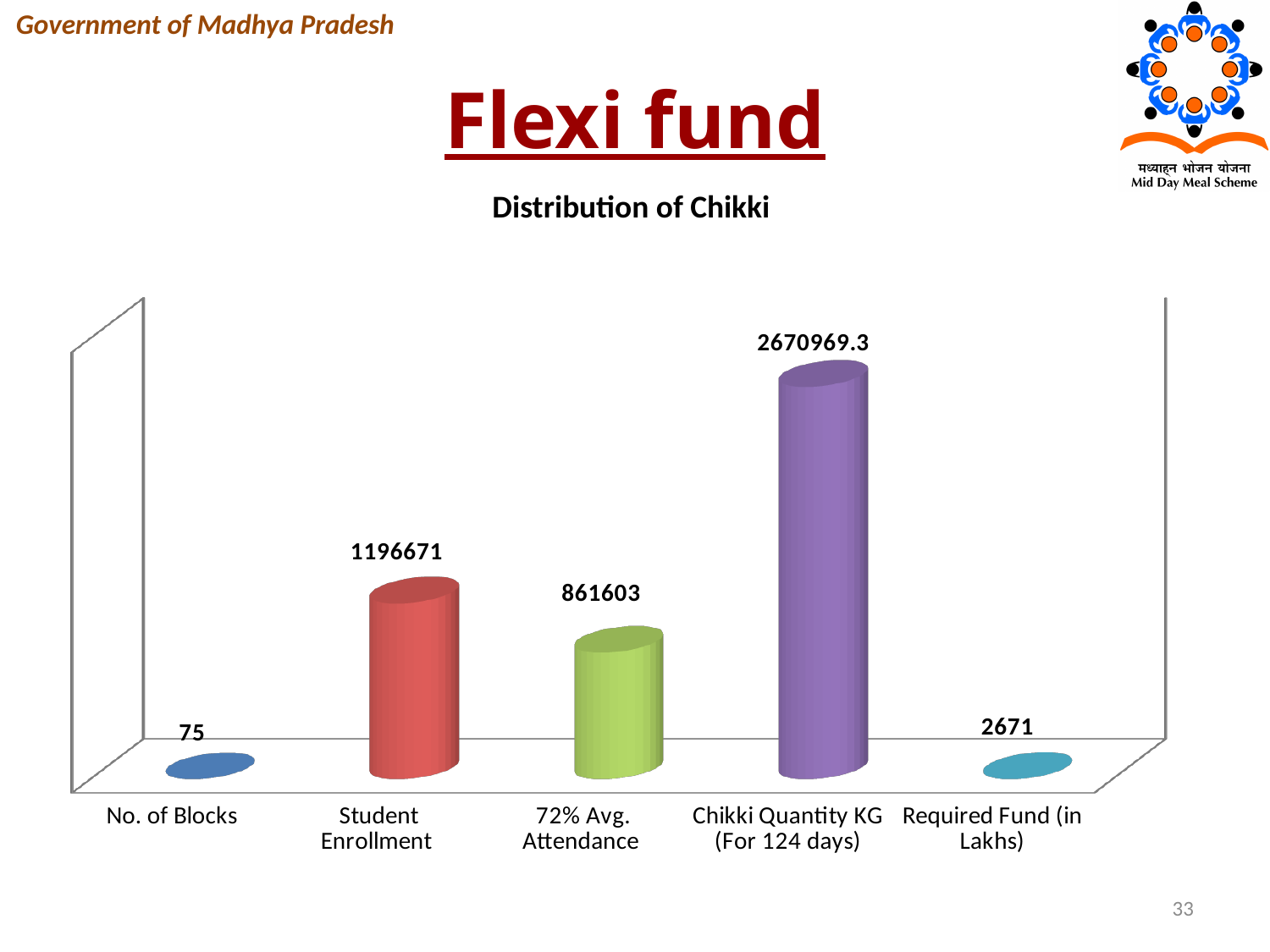
Which category has the lowest value? No. of Blocks What is the value for 72% Avg. Attendance? 861603 What is the value for Chikki Quantity KG (For 124 days)? 2670969.3 Which category has the highest value? Chikki Quantity KG (For 124 days) What is the value for Required Fund (in Lakhs)? 2671 What is the value for No. of Blocks? 75 How many categories are shown in the chart? 5 What is the value for Student Enrollment? 1196671 What kind of chart is shown on the slide? Bar chart What is the difference between Student Enrollment and 72% Avg. Attendance? 335068 Which is larger, Student Enrollment or 72% Avg. Attendance? Student Enrollment What is the title of the chart? Distribution of Chikki